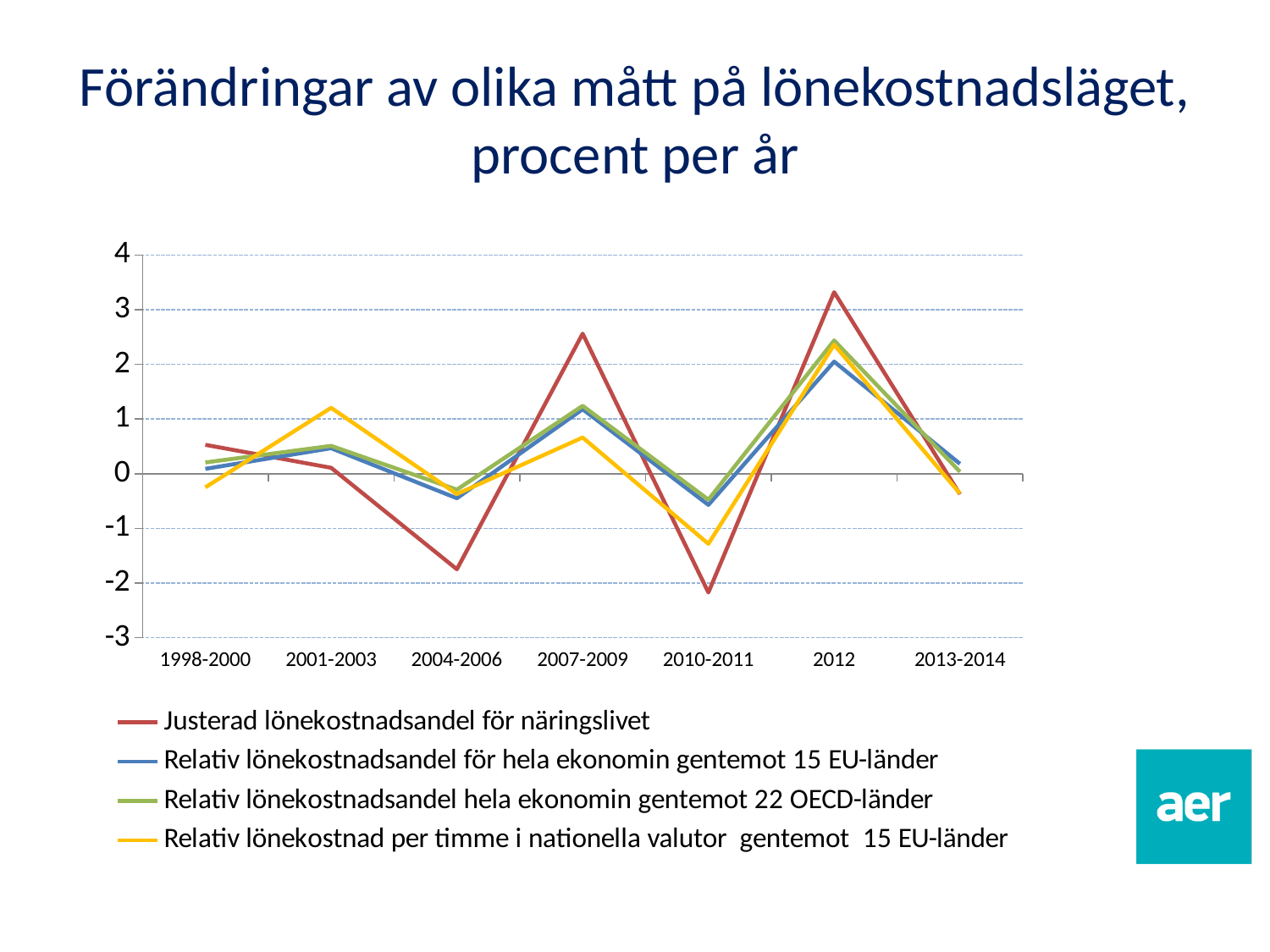
What kind of chart is shown on the slide? line chart Is the value for 'Justerad lönekostnadsandel för näringslivet' in 2012 greater or less than 3? greater Is the value for 'Justerad lönekostnadsandel för näringslivet' in 2004-2006 greater or less than -1? less How many periods are shown on the x axis? 7 In which period does the series 'Relativ lönekostnad per timme i nationella valutor gentemot 15 EU-länder' reach its lowest value? 2010-2011 In which period does the series 'Justerad lönekostnadsandel för näringslivet' reach its lowest value? 2010-2011 How many series does the legend list? 4 In which period does the series 'Justerad lönekostnadsandel för näringslivet' reach its highest value? 2012 What colour is the line for 'Justerad lönekostnadsandel för näringslivet'? red In 2007-2009, which series has the larger value: 'Justerad lönekostnadsandel för näringslivet' or 'Relativ lönekostnad per timme i nationella valutor gentemot 15 EU-länder'? Justerad lönekostnadsandel för näringslivet Does the series 'Justerad lönekostnadsandel för näringslivet' rise or fall from 2012 to 2013-2014? fall Is the value for 'Relativ lönekostnad per timme i nationella valutor gentemot 15 EU-länder' in 2001-2003 greater or less than 1? greater